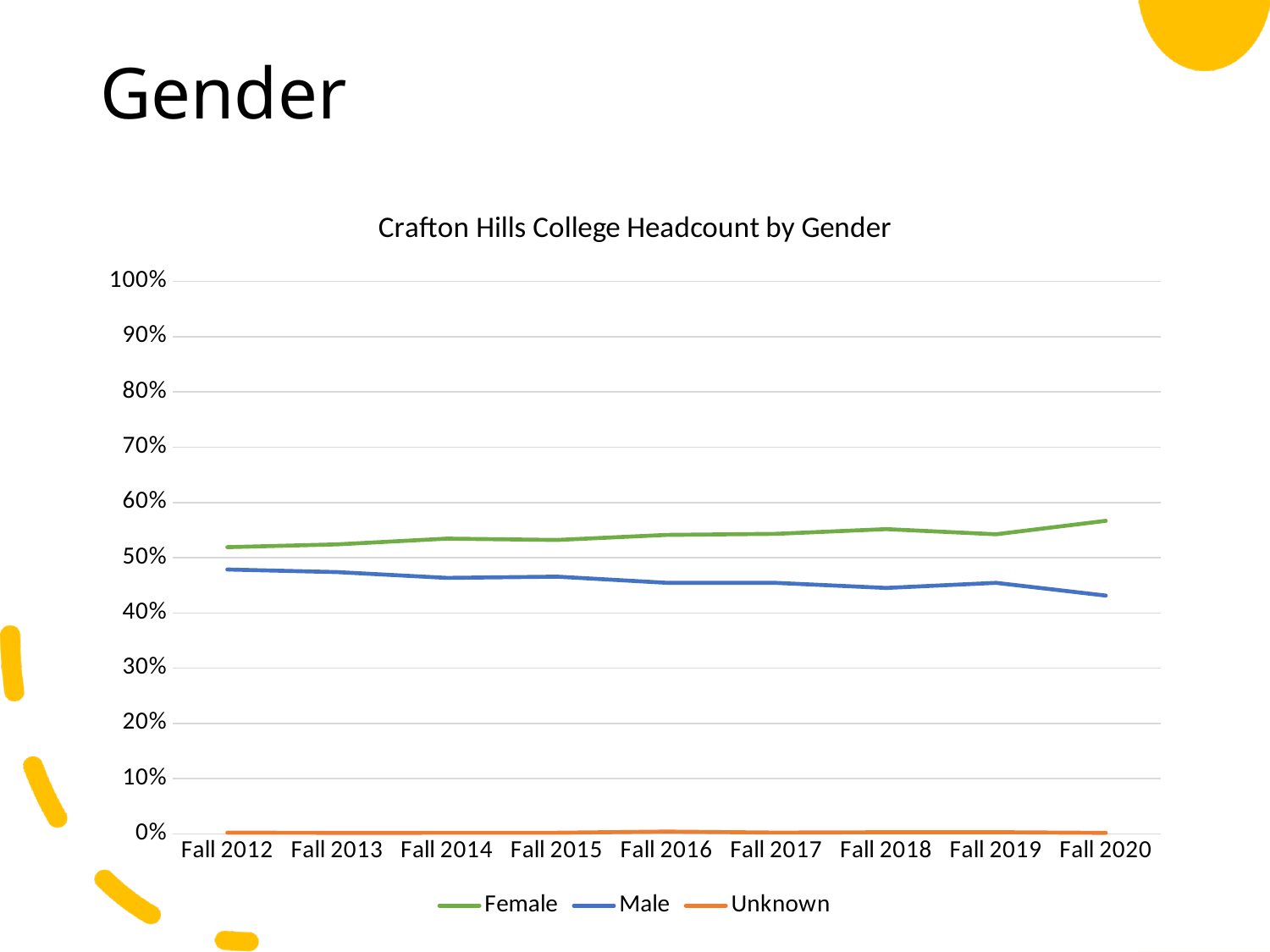
Which series has the lowest values across all terms? Unknown What kind of chart is shown on the slide? line chart Is the Female value for Fall 2020 greater or less than 50%? greater Which series is shown with the green line? Female Is the Unknown value for Fall 2016 greater or less than 10%? less Is the Male value for Fall 2020 greater or less than 50%? less How many Fall terms are plotted along the x axis? 9 What is the title of the chart? Crafton Hills College Headcount by Gender How many series does the legend list? 3 Does the Female line generally rise or fall from Fall 2012 to Fall 2020? rise Does the Male line generally rise or fall from Fall 2012 to Fall 2020? fall In Fall 2020, which is larger, the Female share or the Male share? Female